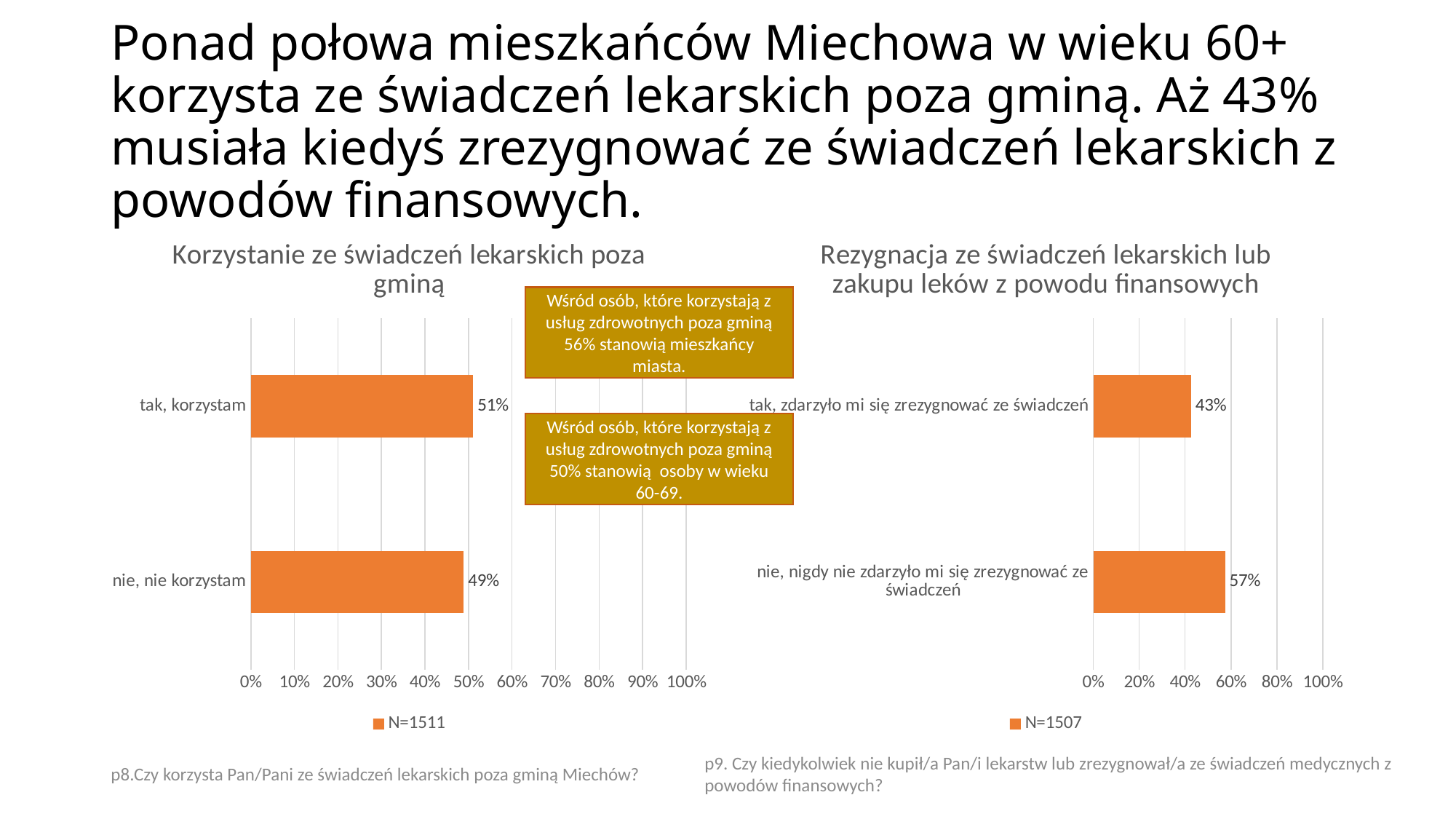
In the chart 'Rezygnacja ze świadczeń lekarskich lub zakupu leków z powodu finansowych', what is the value for 'nie, nigdy nie zdarzyło mi się zrezygnować ze świadczeń'? 57% In the right-hand chart, is the value for 'tak, zdarzyło mi się zrezygnować ze świadczeń' greater or less than 40%? greater What legend entry is shown under the left-hand chart 'Korzystanie ze świadczeń lekarskich poza gminą'? N=1511 In the right-hand chart, what is the difference between the 'nie' and 'tak' values? 14% In the right-hand chart, which category has the highest value? nie, nigdy nie zdarzyło mi się zrezygnować ze świadczeń In the chart 'Korzystanie ze świadczeń lekarskich poza gminą', what is the value for 'nie, nie korzystam'? 49% In the left-hand chart, what is the difference between 'tak, korzystam' and 'nie, nie korzystam'? 2% How many categories does the left-hand chart 'Korzystanie ze świadczeń lekarskich poza gminą' show? 2 In the chart 'Korzystanie ze świadczeń lekarskich poza gminą', what is the value for 'tak, korzystam'? 51% In the chart 'Rezygnacja ze świadczeń lekarskich lub zakupu leków z powodu finansowych', what is the value for 'tak, zdarzyło mi się zrezygnować ze świadczeń'? 43% What type of chart is the right-hand chart 'Rezygnacja ze świadczeń lekarskich lub zakupu leków z powodu finansowych'? bar chart In the left-hand chart, which category has the lowest value? nie, nie korzystam